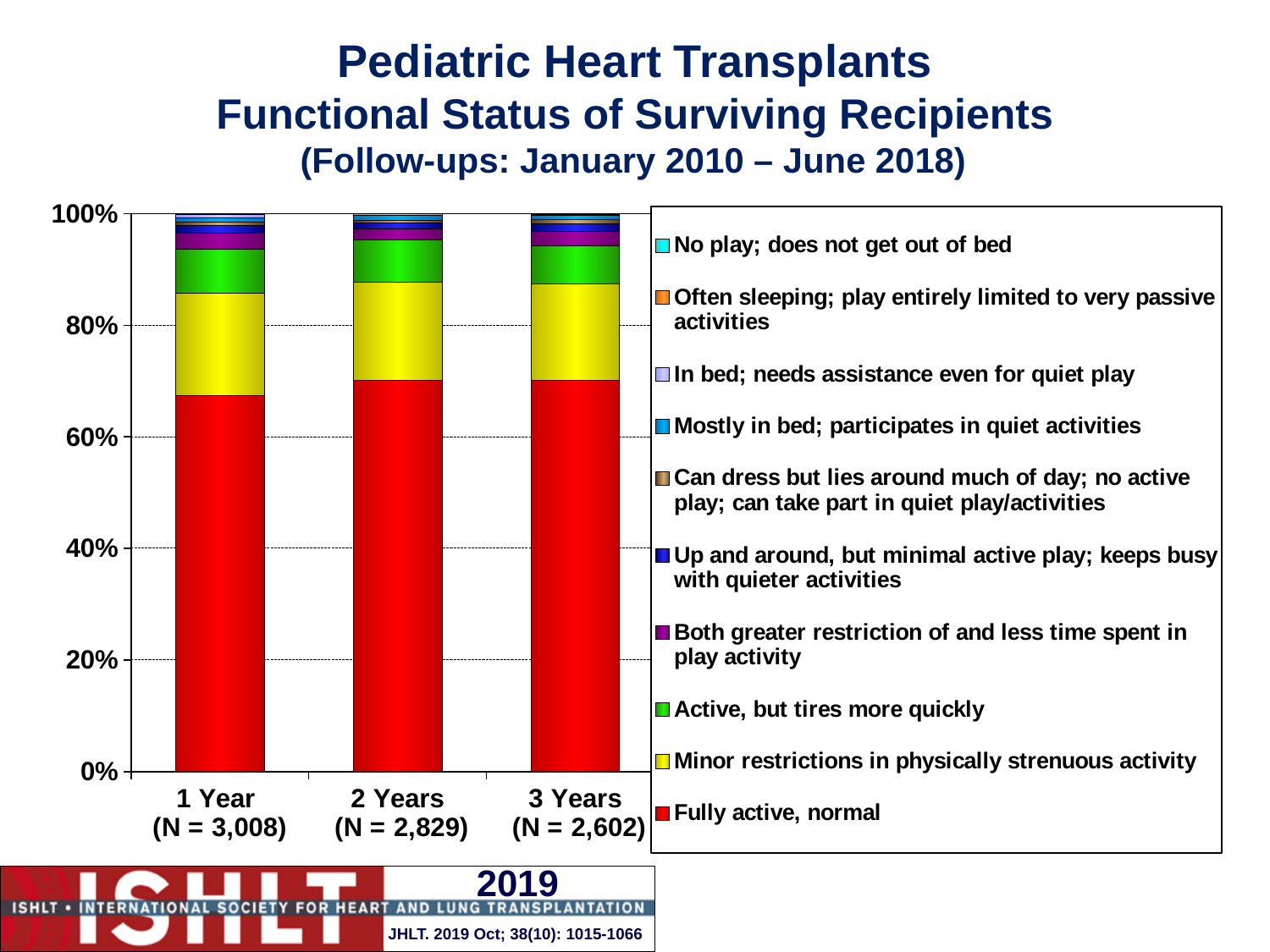
How many functional status categories does the legend list? 10 Is the 'Fully active, normal' share for 2 Years greater or less than 40%? greater What follow-up period is given in the chart title? January 2010 – June 2018 What kind of chart is shown on the slide? Stacked bar chart Which functional status category makes up the largest segment of the 1 Year bar? Fully active, normal Is the 'Fully active, normal' share for 1 Year greater or less than 60%? greater How many follow-up time categories are shown on the x axis? 3 Which legend entry is shown in red? Fully active, normal What is the N value shown for the 2 Years category? N = 2,829 Is the 'Fully active, normal' share for 3 Years greater or less than 80%? less What is the N value shown for the 1 Year category? N = 3,008 What is the N value shown for the 3 Years category? N = 2,602